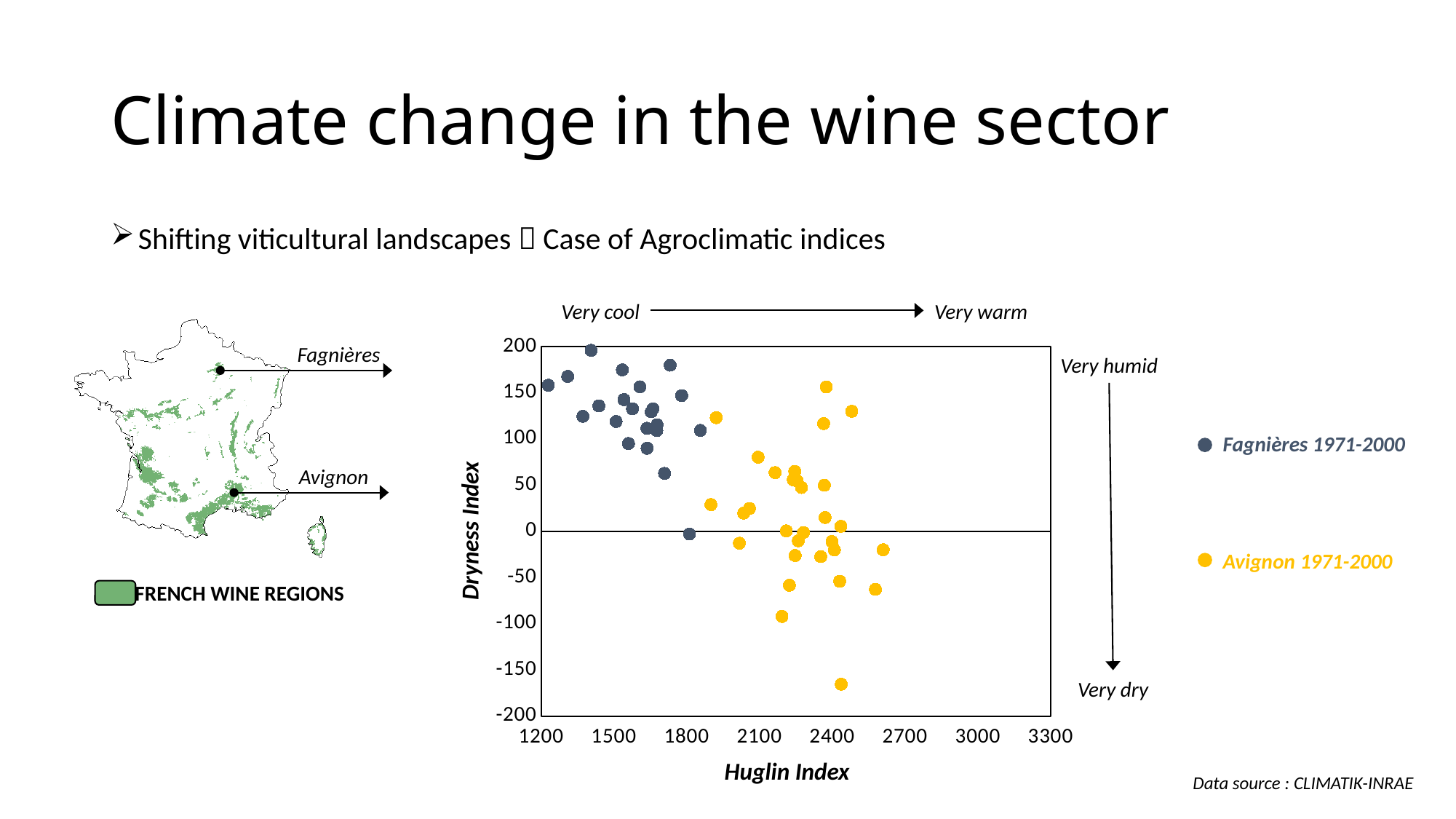
Is the highest Dryness Index value for Fagnières 1971-2000 greater or less than 150? greater Are the Huglin Index values of all Avignon 1971-2000 points greater or less than 1800? greater As the Huglin Index increases along the x axis, does the Dryness Index generally rise or fall? Fall What is the title of the chart's horizontal axis? Huglin Index Which series has the higher Dryness Index values overall, Fagnières 1971-2000 or Avignon 1971-2000? Fagnières 1971-2000 Which series has the lowest Dryness Index value on the chart? Avignon 1971-2000 Are the Huglin Index values of all Fagnières 1971-2000 points greater or less than 2100? less How many series does the chart's legend list? 2 Which series has the higher Huglin Index values overall, Fagnières 1971-2000 or Avignon 1971-2000? Avignon 1971-2000 What kind of chart is shown on the slide? Scatter chart Which two series are listed in the chart's legend? Fagnières 1971-2000 and Avignon 1971-2000